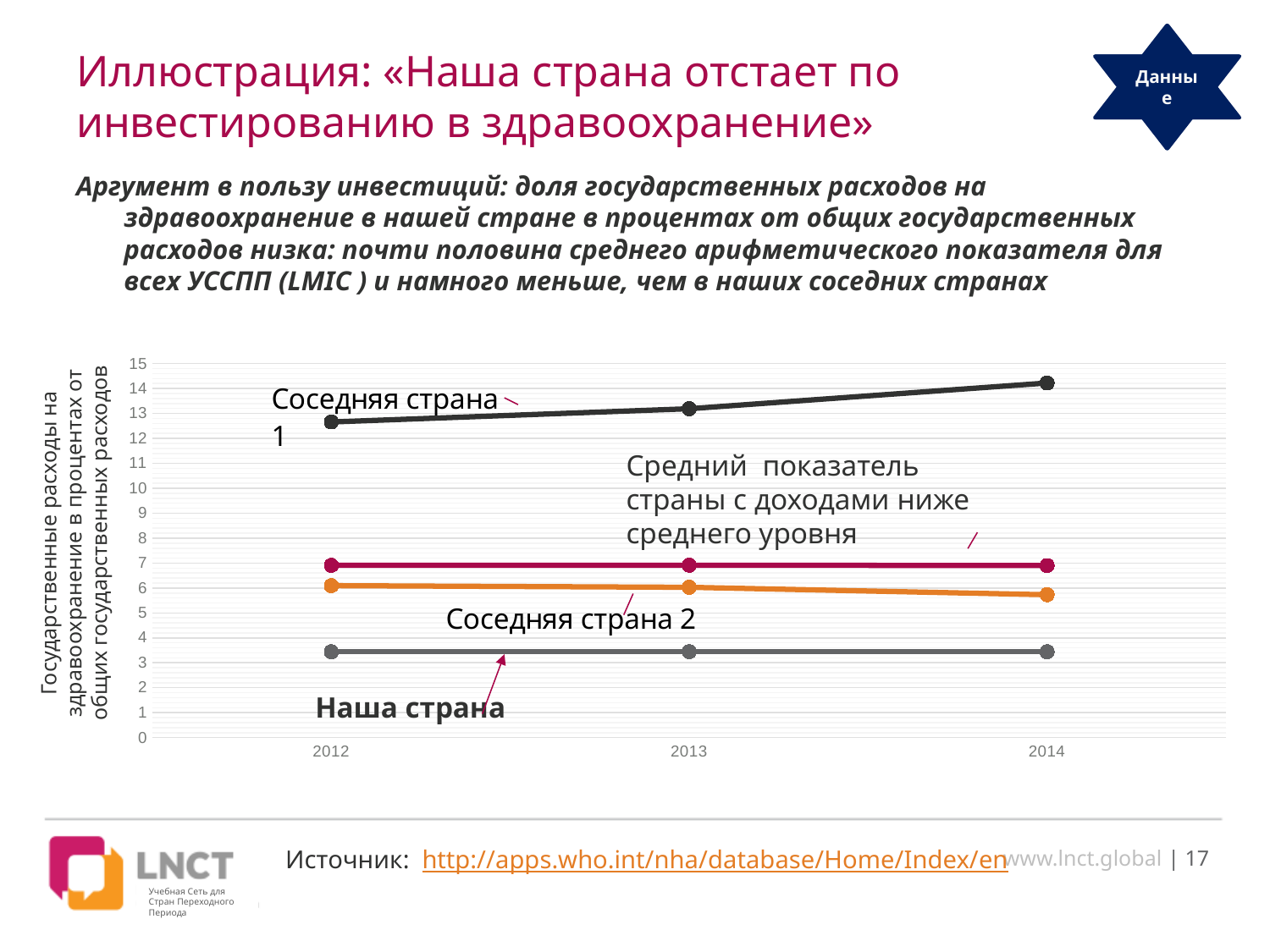
Does the line for Соседняя страна 1 rise or fall from 2012 to 2014? rise How many years are plotted along the x axis of the chart? 3 In 2013, which is larger: the value for Соседняя страна 2 or the value for Наша страна? Соседняя страна 2 Is the value for Соседняя страна 2 in 2012 greater or less than 5? greater What is the maximum value shown on the y axis of the chart? 15 Is the value for Наша страна in 2014 greater or less than 5? less Does the line for Соседняя страна 2 rise or fall from 2012 to 2014? fall Which series has the highest values in the chart? Соседняя страна 1 Which years are shown on the x axis of the chart? 2012, 2013, 2014 Which series has the lowest values in the chart? Наша страна Is the value for Соседняя страна 1 in 2014 greater or less than 14? greater What kind of chart is shown on the slide? line chart